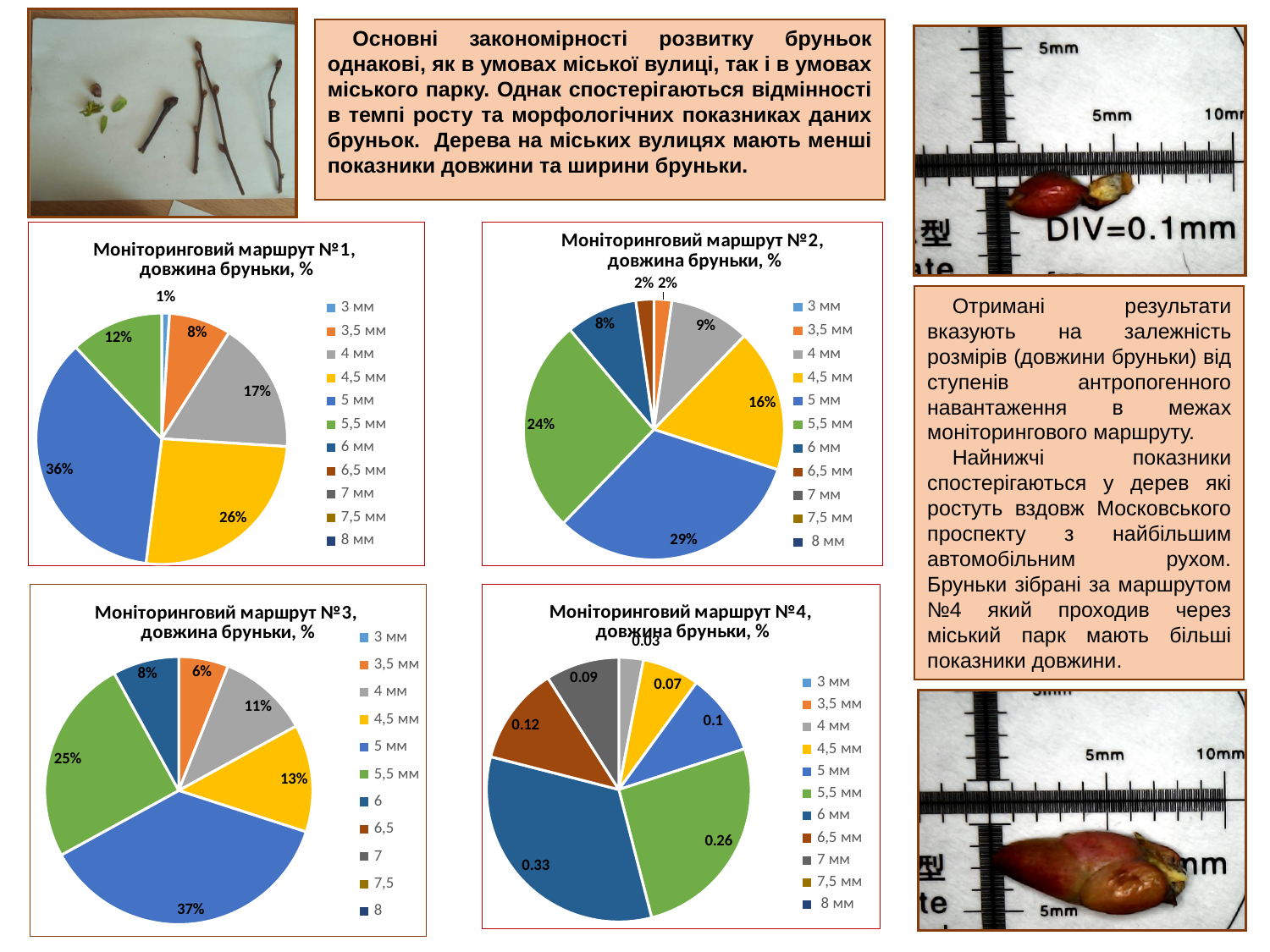
In the chart titled "Моніторинговий маршрут №2, довжина бруньки, %", how many entries does the legend list? 11 What type of chart is used for "Моніторинговий маршрут №4, довжина бруньки, %"? Pie chart In the chart titled "Моніторинговий маршрут №1, довжина бруньки, %", what is the difference between the shares for 4,5 мм and 4 мм? 9% In the chart titled "Моніторинговий маршрут №3, довжина бруньки, %", what is the difference between the shares for 5,5 мм and 4,5 мм? 12% In the chart titled "Моніторинговий маршрут №1, довжина бруньки, %", which bud length has the largest slice? 5 мм In the chart titled "Моніторинговий маршрут №4, довжина бруньки, %", what value is shown for 6 мм? 0.33 In the chart titled "Моніторинговий маршрут №1, довжина бруньки, %", what share is shown for 5 мм? 36% In the chart titled "Моніторинговий маршрут №3, довжина бруньки, %", what share is shown for 3,5 мм? 6% In the chart titled "Моніторинговий маршрут №2, довжина бруньки, %", what share is shown for 5,5 мм? 24% In the chart titled "Моніторинговий маршрут №2, довжина бруньки, %", which is larger, the share for 5 мм or the share for 4,5 мм? 5 мм In the chart titled "Моніторинговий маршрут №3, довжина бруньки, %", what share is shown for 5 мм? 37% In the chart titled "Моніторинговий маршрут №4, довжина бруньки, %", which bud length has the largest slice? 6 мм